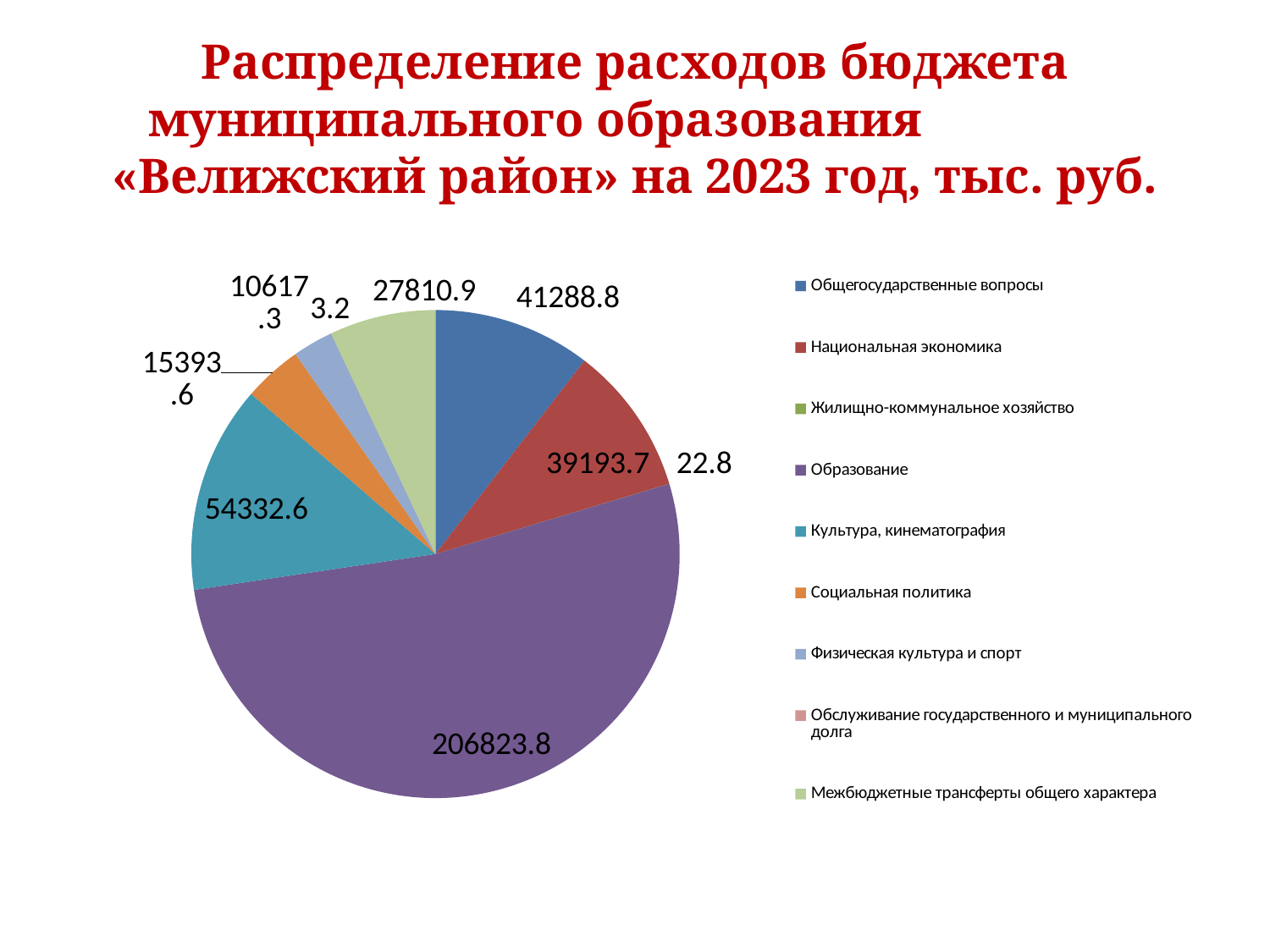
What colour is the slice for Образование? purple What kind of chart is shown on the slide? pie chart What is the value for Социальная политика? 15393.6 What is the difference between the values for Общегосударственные вопросы and Национальная экономика? 2095.1 What is the value for Общегосударственные вопросы? 41288.8 What is the value for Межбюджетные трансферты общего характера? 27810.9 What is the value for Культура, кинематография? 54332.6 Which is larger, the value for Культура, кинематография or the value for Межбюджетные трансферты общего характера? Культура, кинематография Which category has the smallest value? Обслуживание государственного и муниципального долга Which category has the largest slice of the pie? Образование How many categories does the legend list? 9 What is the value for Образование? 206823.8